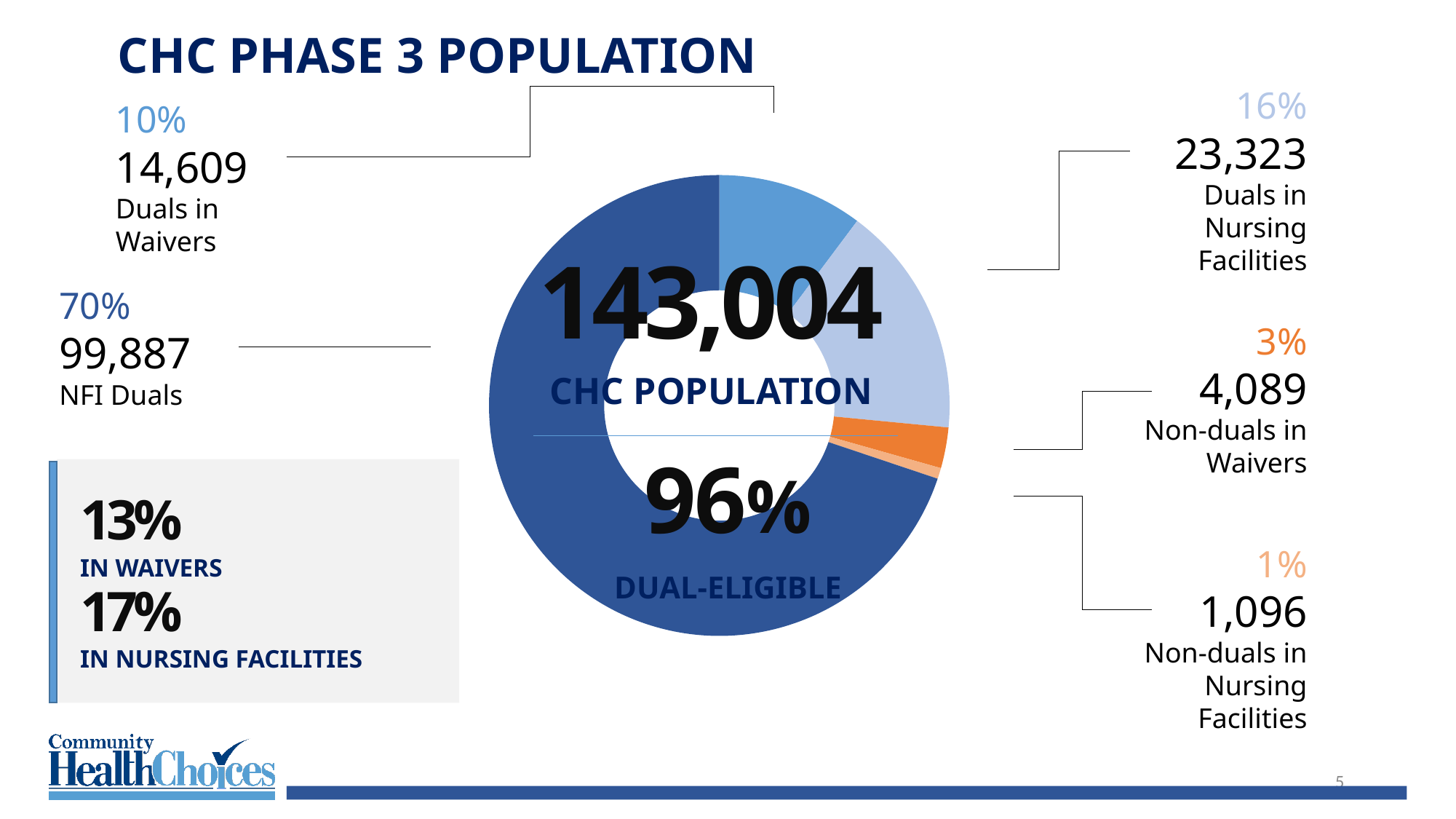
What share of the CHC population are NFI Duals? 70% Which is larger: Non-duals in Waivers or Non-duals in Nursing Facilities? Non-duals in Waivers Which segment of the chart is the largest? NFI Duals Which segment of the chart is the smallest? Non-duals in Nursing Facilities How many Duals in Nursing Facilities are there? 23,323 What percentage of the CHC population is dual-eligible? 96% How many NFI Duals are there? 99,887 What is the total CHC population shown in the centre of the chart? 143,004 What kind of chart is shown on the slide? Pie chart (donut) What share of the CHC population are Non-duals in Waivers? 3% How many segments does the donut chart have? 5 What is the difference between the number of Duals in Nursing Facilities and Duals in Waivers? 8,714